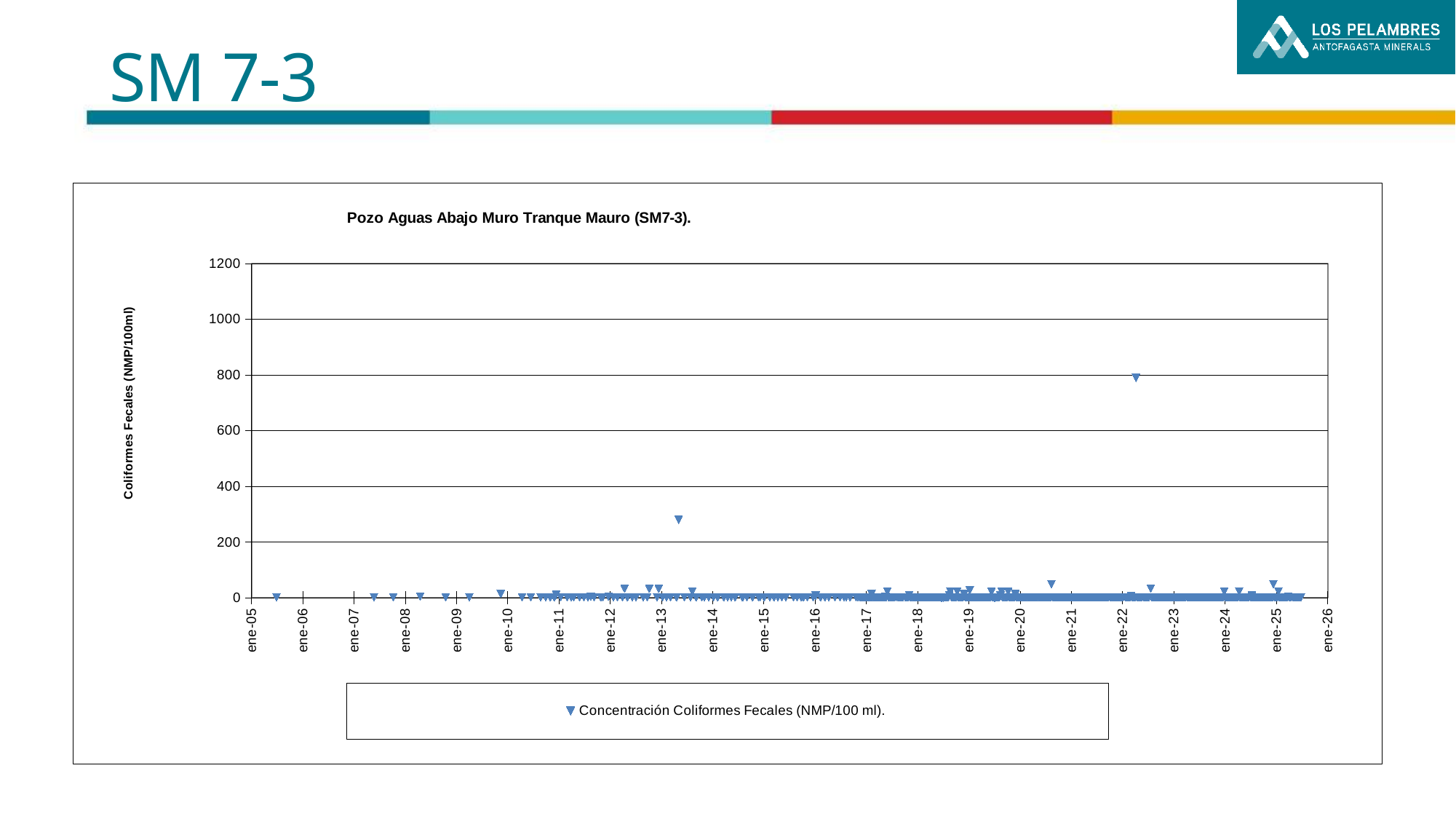
How many tick labels are shown on the x axis? 22 What kind of chart is shown on the slide? scatter chart Between which two x-axis labels does the highest point of the series fall? ene-22 and ene-23 What is the title of the chart? Pozo Aguas Abajo Muro Tranque Mauro (SM7-3). What is the legend entry for the plotted series? Concentración Coliformes Fecales (NMP/100 ml). Is the isolated high point between ene-13 and ene-14 greater or less than 200? greater Which is larger: the peak between ene-22 and ene-23 or the peak between ene-13 and ene-14? the peak between ene-22 and ene-23 Are the majority of the plotted values greater or less than 200? less Is the highest plotted value greater or less than 1000? less How many series does the legend list? 1